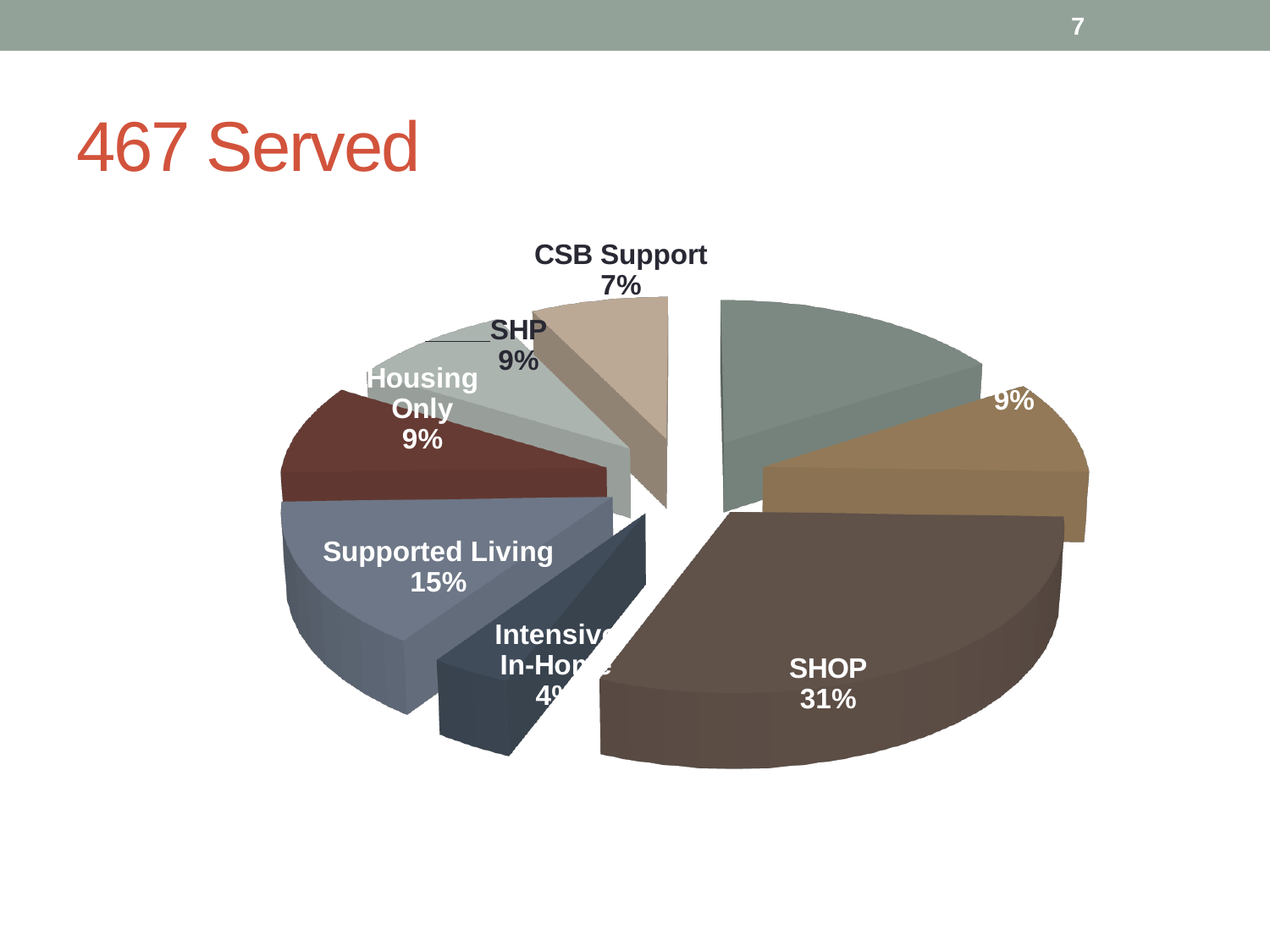
What kind of chart is shown on the slide? Pie chart What percentage is shown for CSB Support? 7% How many percentage points larger is SHOP than Supported Living? 16 percentage points How many slices does the pie chart have? 8 Which labeled category has the smallest slice of the pie? Intensive In-Home What percentage of the pie does the SHOP slice represent? 31% What percentage is shown for SHP? 9% What percentage is shown for Housing Only? 9% What percentage is shown for Supported Living? 15% What is the title of the slide above the chart? 467 Served Which is larger, the Supported Living slice or the CSB Support slice? Supported Living Which category has the largest slice of the pie? SHOP